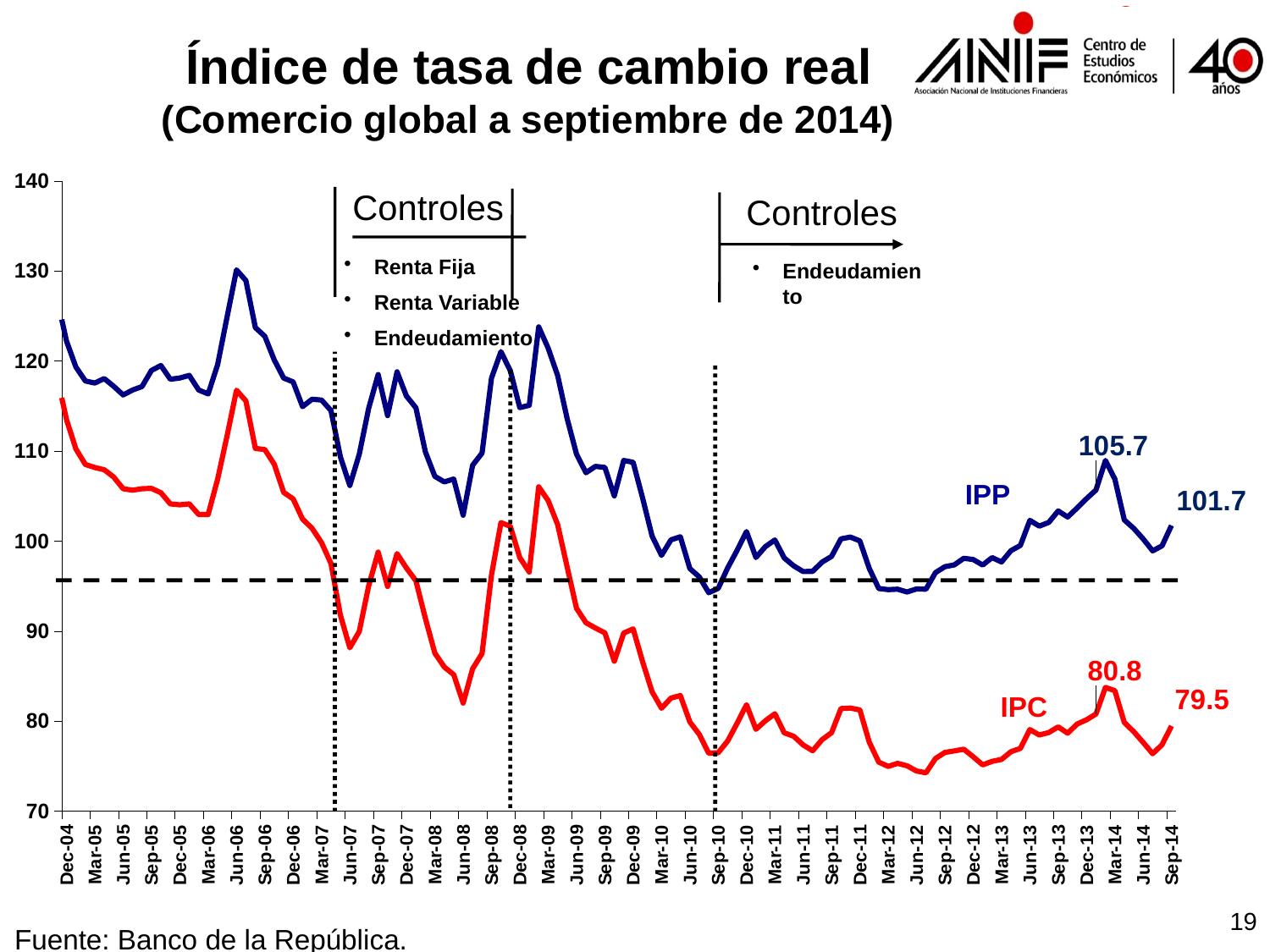
What kind of chart is shown on the slide? line chart How many data series are plotted on the chart? 2 At Sep-14, which series has the higher value, IPP or IPC? IPP What is the difference between the IPP value and the IPC value at Sep-14? 22.2 Is the value of the IPP series at Dec-04 greater or less than 120? greater By how much did the IPP series fall from its labelled 2014 peak of 105.7 to its Sep-14 value? 4.0 What is the value of the IPC series at Sep-14? 79.5 What is the labelled peak value of the IPP series in early 2014? 105.7 What is the labelled peak value of the IPC series in early 2014? 80.8 Is the value of the IPC series at Jun-12 greater or less than 80? less What is the value of the IPP series at Sep-14? 101.7 Overall, does the IPC series rise or fall from Dec-04 to Sep-14? fall